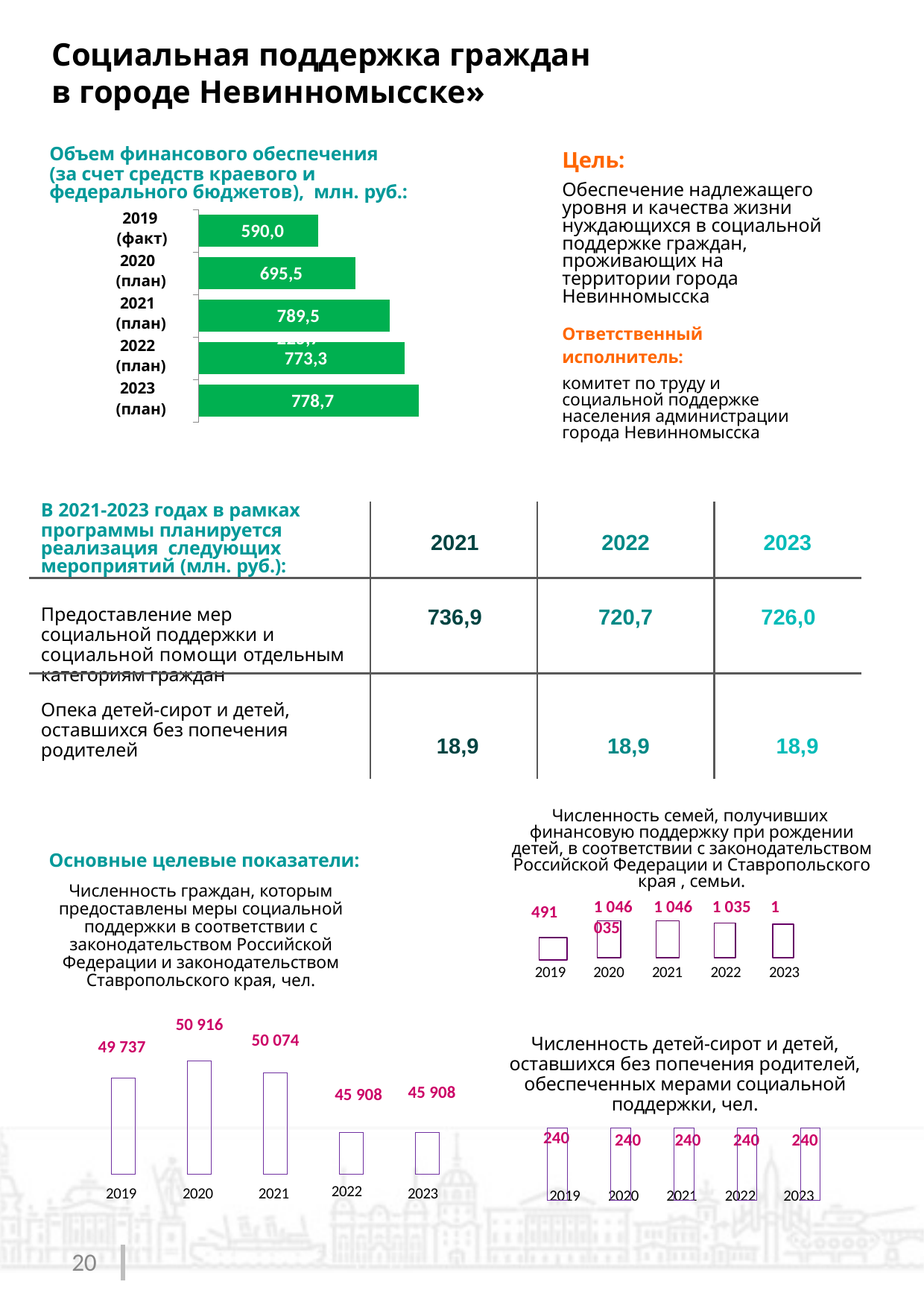
In the chart 'Объем финансового обеспечения (за счет средств краевого и федерального бюджетов), млн. руб.', what is the value for 2019 (факт)? 590,0 In the chart 'Объем финансового обеспечения', which year has the highest value? 2021 (план) In the chart 'Объем финансового обеспечения', which year has the lowest value? 2019 (факт) In the chart 'Численность семей, получивших финансовую поддержку при рождении детей', what is the value for 2019? 491 In the chart 'Объем финансового обеспечения', what is the difference between the 2020 (план) and 2019 (факт) values? 105,5 In the chart 'Численность детей-сирот и детей, оставшихся без попечения родителей, обеспеченных мерами социальной поддержки, чел.', what is the value for 2023? 240 In the chart 'Объем финансового обеспечения', what is the value for 2023 (план)? 778,7 In the chart 'Численность граждан, которым предоставлены меры социальной поддержки', what is the value for 2020? 50 916 How many years are shown in the chart 'Численность граждан, которым предоставлены меры социальной поддержки'? 5 In the chart 'Численность граждан, которым предоставлены меры социальной поддержки', is the value for 2021 larger or smaller than the value for 2022? Larger What kind of chart is 'Объем финансового обеспечения'? Bar chart In the chart 'Численность граждан, которым предоставлены меры социальной поддержки', which year has the highest value? 2020